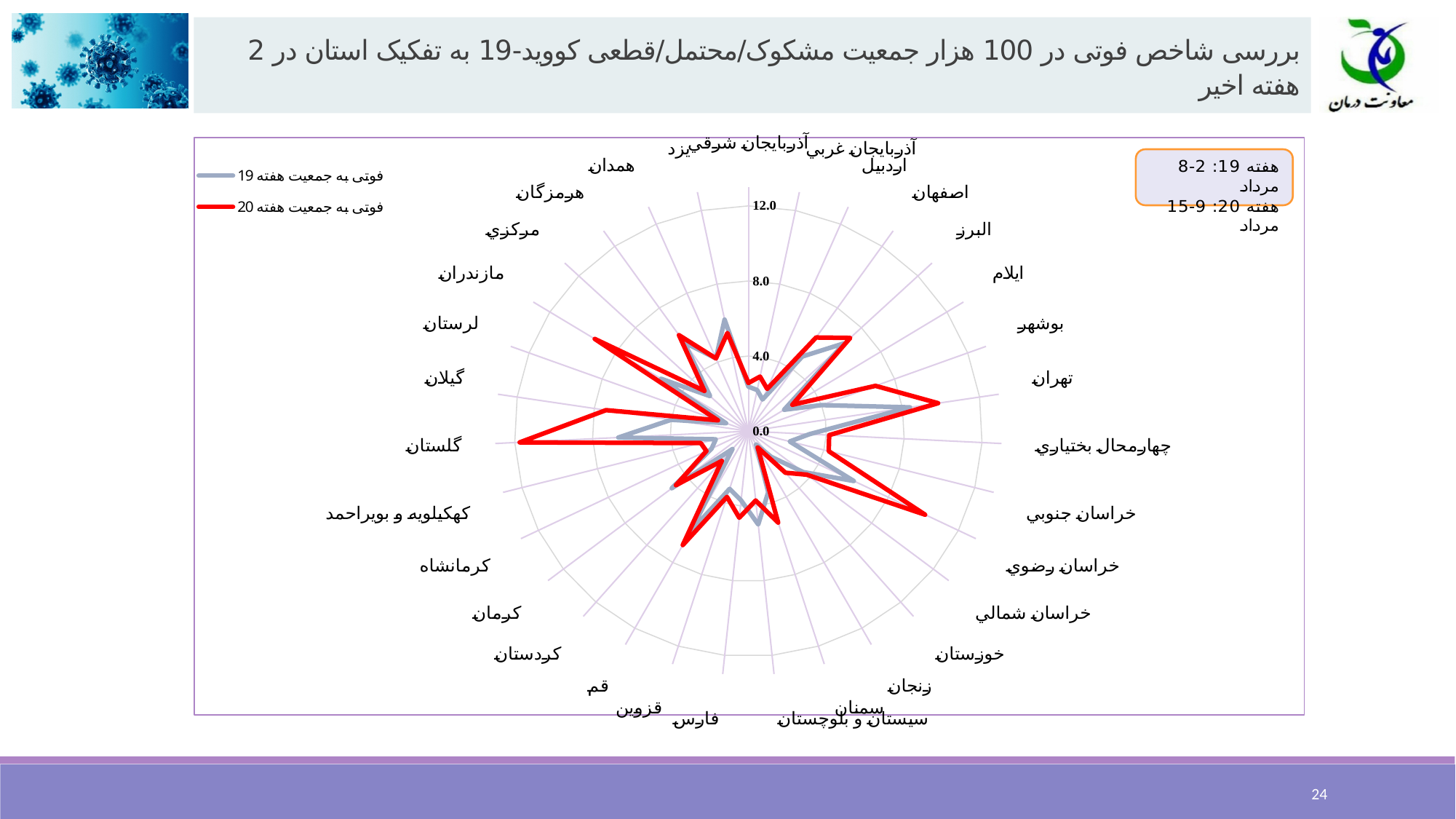
In the series فوتی به جمعیت هفته 20, which province has the larger value: گلستان or تهران? گلستان For گلستان, which series has the larger value: فوتی به جمعیت هفته 19 or فوتی به جمعیت هفته 20? فوتی به جمعیت هفته 20 How many provinces (categories) are plotted around the radar chart? 31 How many series does the legend list? 2 Is the value for گلستان in the series فوتی به جمعیت هفته 20 greater or less than 8.0? greater Which province has the highest value for the series فوتی به جمعیت هفته 20 (red line)? گلستان Which colour represents the series فوتی به جمعیت هفته 20 in the legend? red Is the value for تهران in the series فوتی به جمعیت هفته 20 greater or less than 4.0? greater What kind of chart is shown on the slide? radar chart What is the highest tick value shown on the radial axis of the chart? 12.0